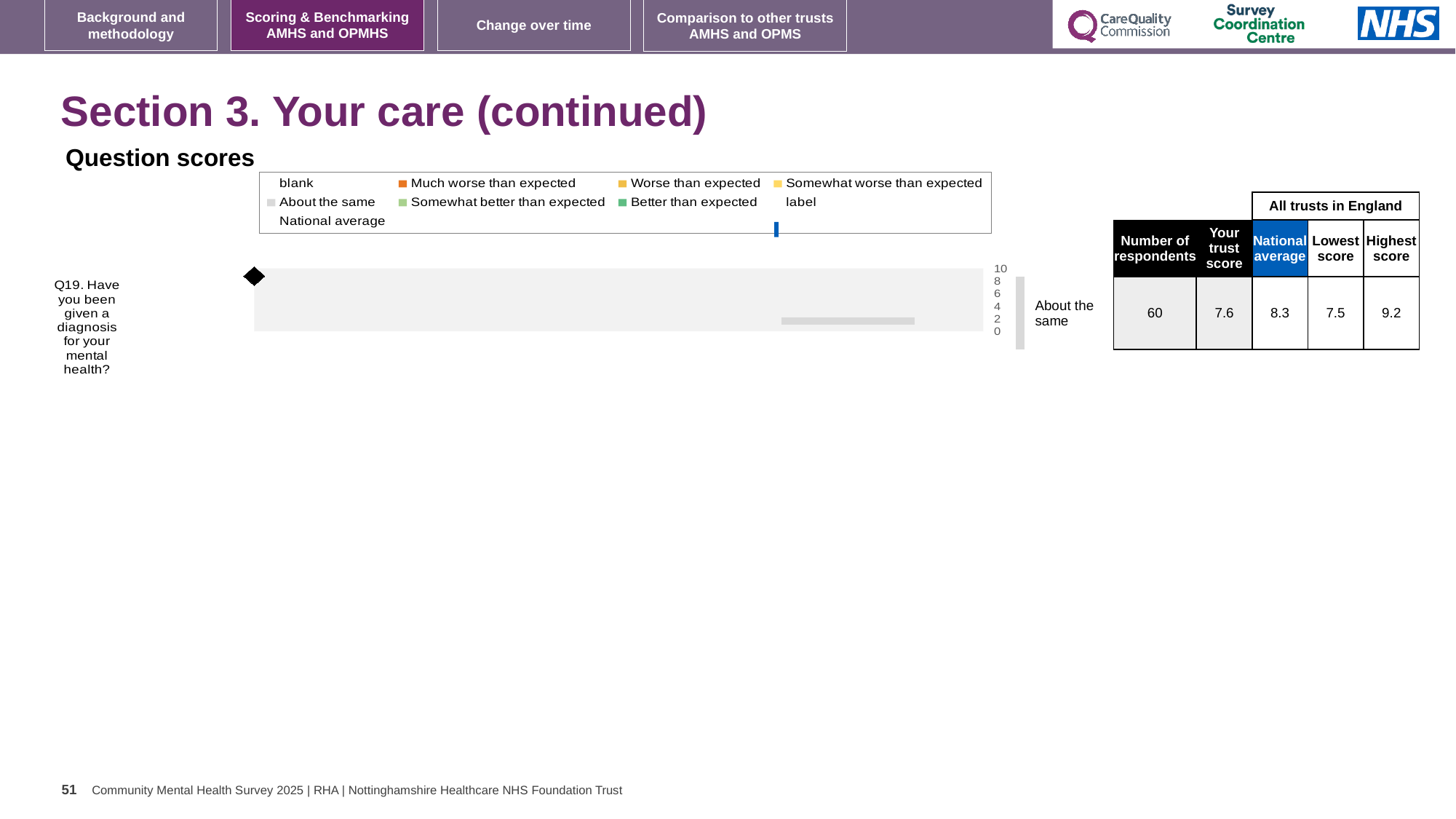
What benchmark category is shown for Q19? About the same What is the national average score for Q19? 8.3 Which is larger for Q19, the trust score or the national average? national average What is the difference between the national average and the trust score for Q19? 0.7 What is the lowest score among all trusts in England for Q19? 7.5 What is the trust score for Q19? 7.6 How many respondents answered Q19? 60 What is the highest score among all trusts in England for Q19? 9.2 What kind of chart is used to show the Q19 score? bar chart How many questions are plotted on the chart? 1 Which question is shown on the chart? Q19. Have you been given a diagnosis for your mental health? Is the trust score for Q19 greater or less than 8? less